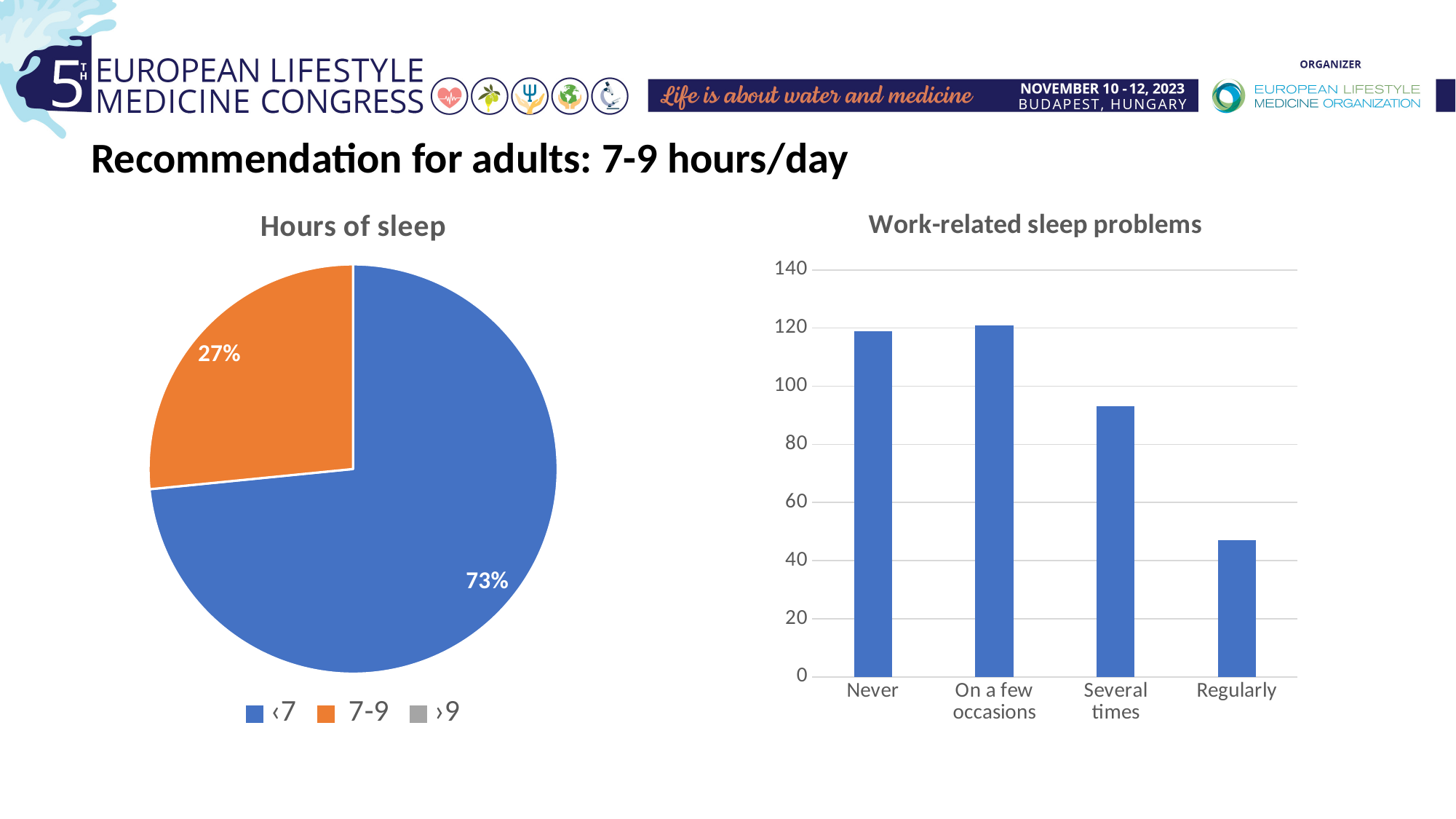
In the Hours of sleep pie chart, what share is shown for the 7-9 category? 27% In the Work-related sleep problems chart, which category has the lowest value? Regularly In the Work-related sleep problems chart, is the value for Regularly greater or less than 60? less In the Hours of sleep pie chart, what share is shown for the <7 category? 73% What kind of chart is the Work-related sleep problems chart? Bar chart In the Hours of sleep pie chart, what is the difference in percentage points between the <7 and 7-9 slices? 46 percentage points What kind of chart is the Hours of sleep chart? Pie chart How many categories does the legend of the Hours of sleep chart list? 3 In the Work-related sleep problems chart, is the value for Never greater or less than 100? greater How many categories are shown on the x axis of the Work-related sleep problems chart? 4 In the Hours of sleep pie chart, which category has the largest slice? <7 In the Work-related sleep problems chart, which is larger, the value for Several times or the value for Regularly? Several times